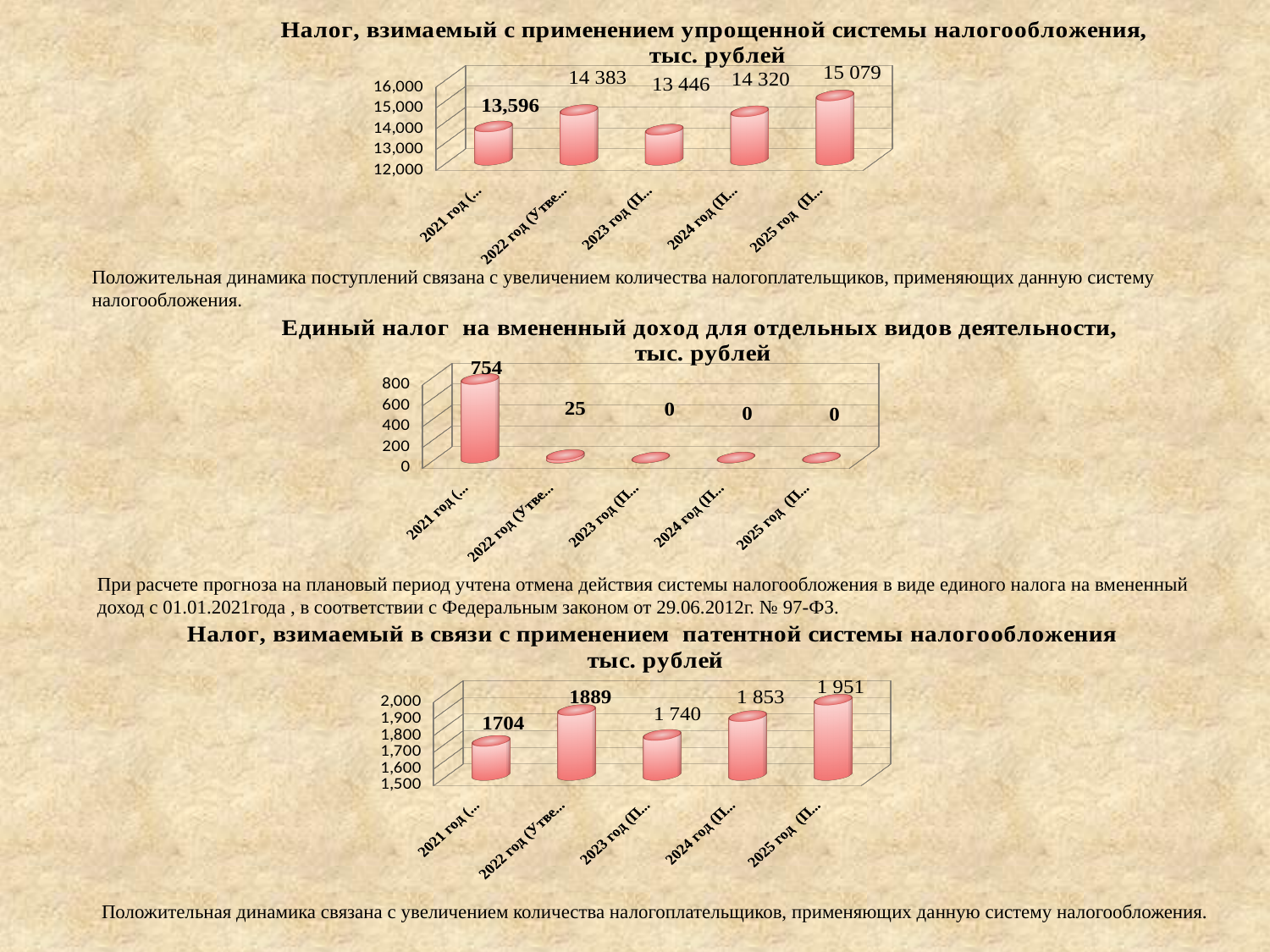
What type of chart is the top chart? Bar chart In the bottom chart (Налог, взимаемый в связи с применением патентной системы налогообложения), what is the value for 2022? 1889 In the middle chart, how many bars are plotted? 5 In the bottom chart, which year has the highest value? 2025 In the top chart (Налог, взимаемый с применением упрощенной системы налогообложения), what is the value for 2021? 13,596 In the top chart, which year has the lowest value? 2023 In the bottom chart, which is larger: the value for 2023 or the value for 2024? 2024 In the top chart, which year has the highest value? 2025 In the top chart, what is the value for 2025? 15 079 In the middle chart, what is the value for 2022? 25 In the bottom chart, what is the difference between the values for 2025 and 2021? 247 In the middle chart (Единый налог на вмененный доход), what is the value for 2021? 754